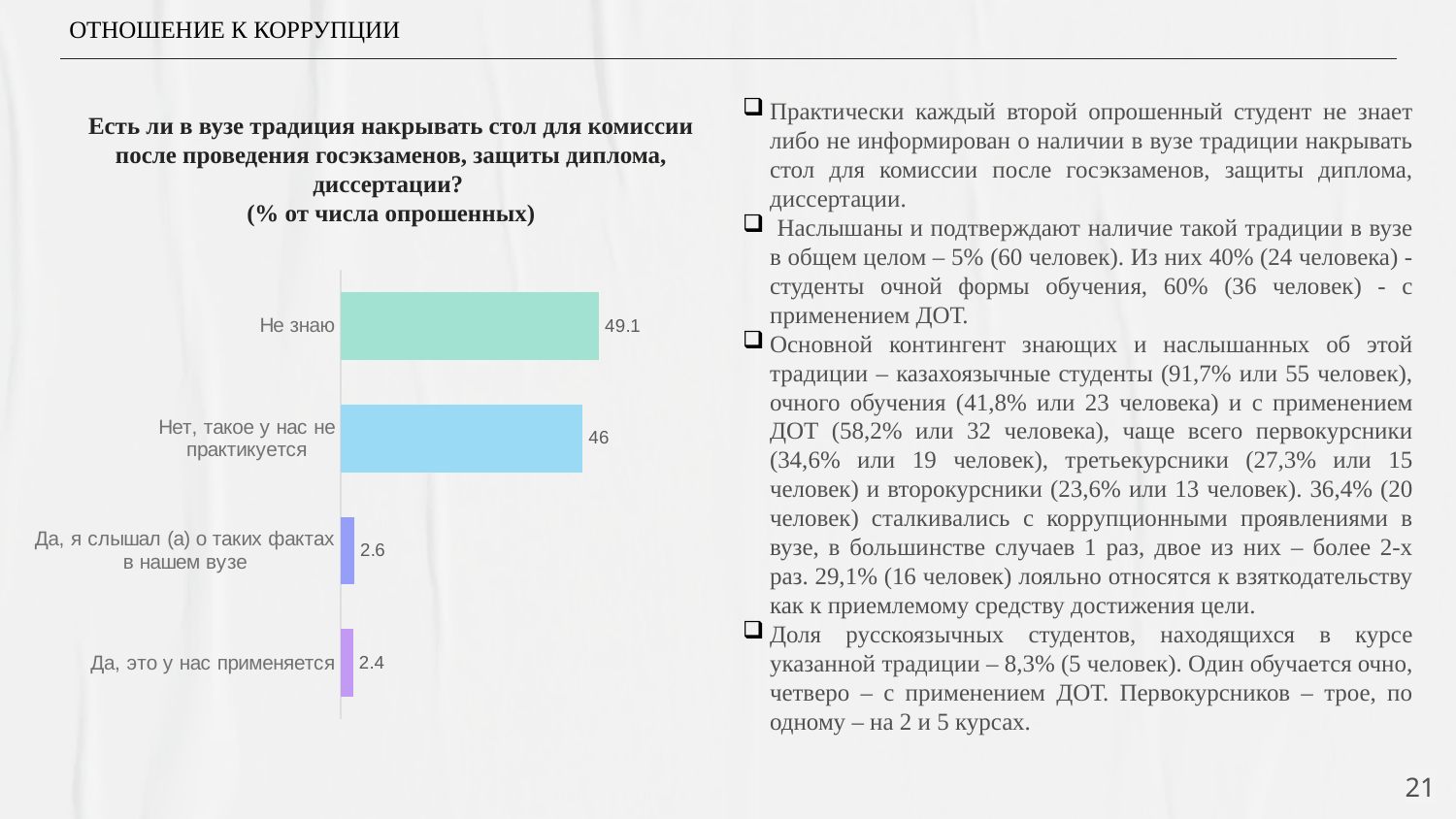
Which is larger: the value for "Да, я слышал (а) о таких фактах в нашем вузе" or for "Да, это у нас применяется"? Да, я слышал (а) о таких фактах в нашем вузе What kind of chart is shown on the slide? Bar chart What is the difference between the values for "Да, я слышал (а) о таких фактах в нашем вузе" and "Да, это у нас применяется"? 0.2 How many categories are shown in the chart? 4 What unit does the chart title say the values are expressed in? % от числа опрошенных What is the value for "Не знаю"? 49.1 What is the value for "Нет, такое у нас не практикуется"? 46 Which category has the lowest value? Да, это у нас применяется What is the value for "Да, я слышал (а) о таких фактах в нашем вузе"? 2.6 What is the difference between the values for "Не знаю" and "Нет, такое у нас не практикуется"? 3.1 Which category has the highest value? Не знаю What is the value for "Да, это у нас применяется"? 2.4